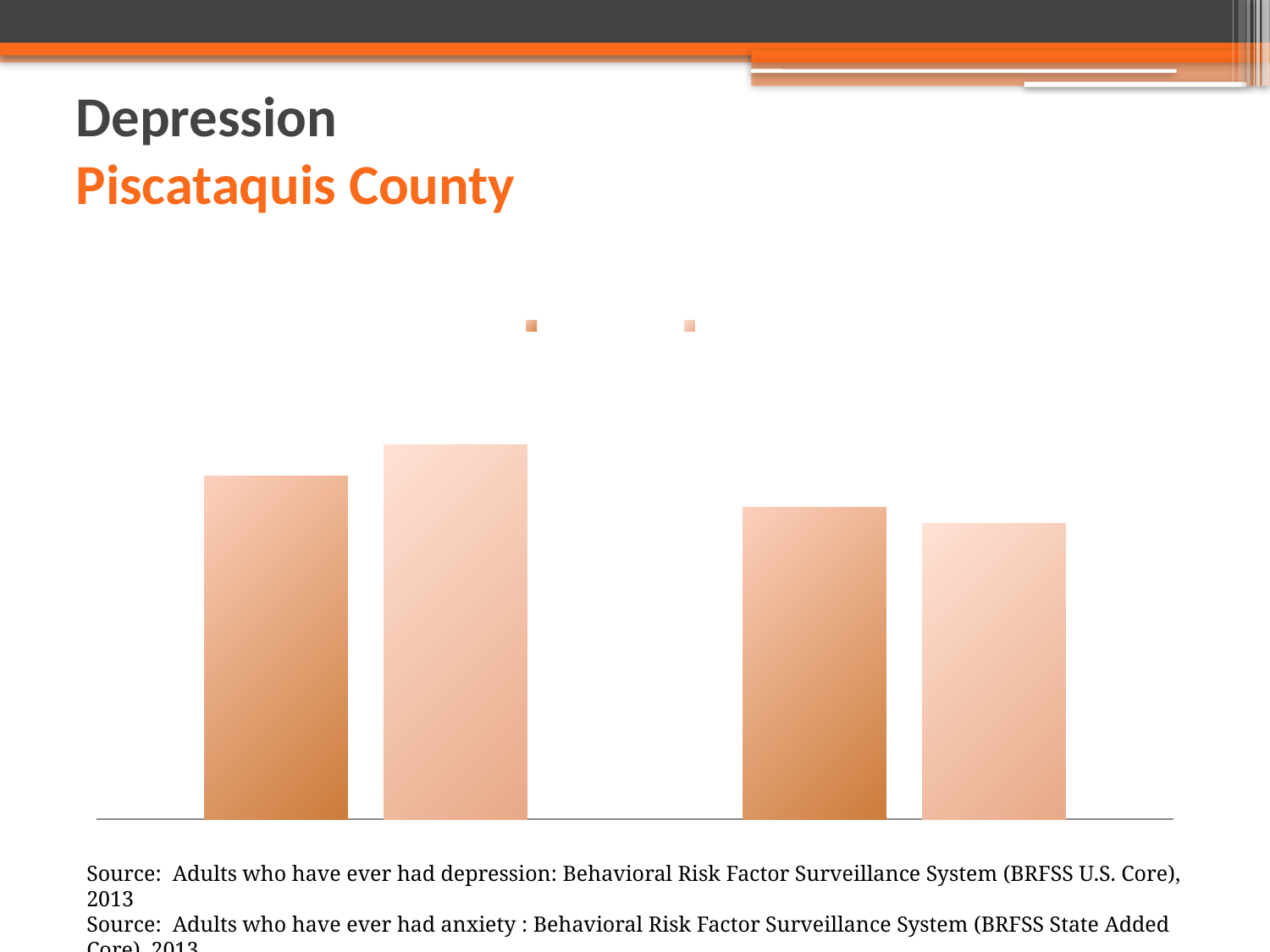
How many bars are plotted in the chart? 4 Which bar is the shortest in the chart, counting from the left? the fourth bar How many groups of bars are there in the chart? 2 Which bar is the tallest in the chart, counting from the left? the second bar Is the left group of bars taller or shorter overall than the right group? taller In the left group of bars, is the darker bar or the lighter bar taller? the lighter bar In the right group of bars, is the darker bar or the lighter bar taller? the darker bar What county is named in the slide title above the chart? Piscataquis County What kind of chart is shown on the slide? bar chart How many series does the chart's legend list? 2 What health topic is named in the slide title above the chart? Depression